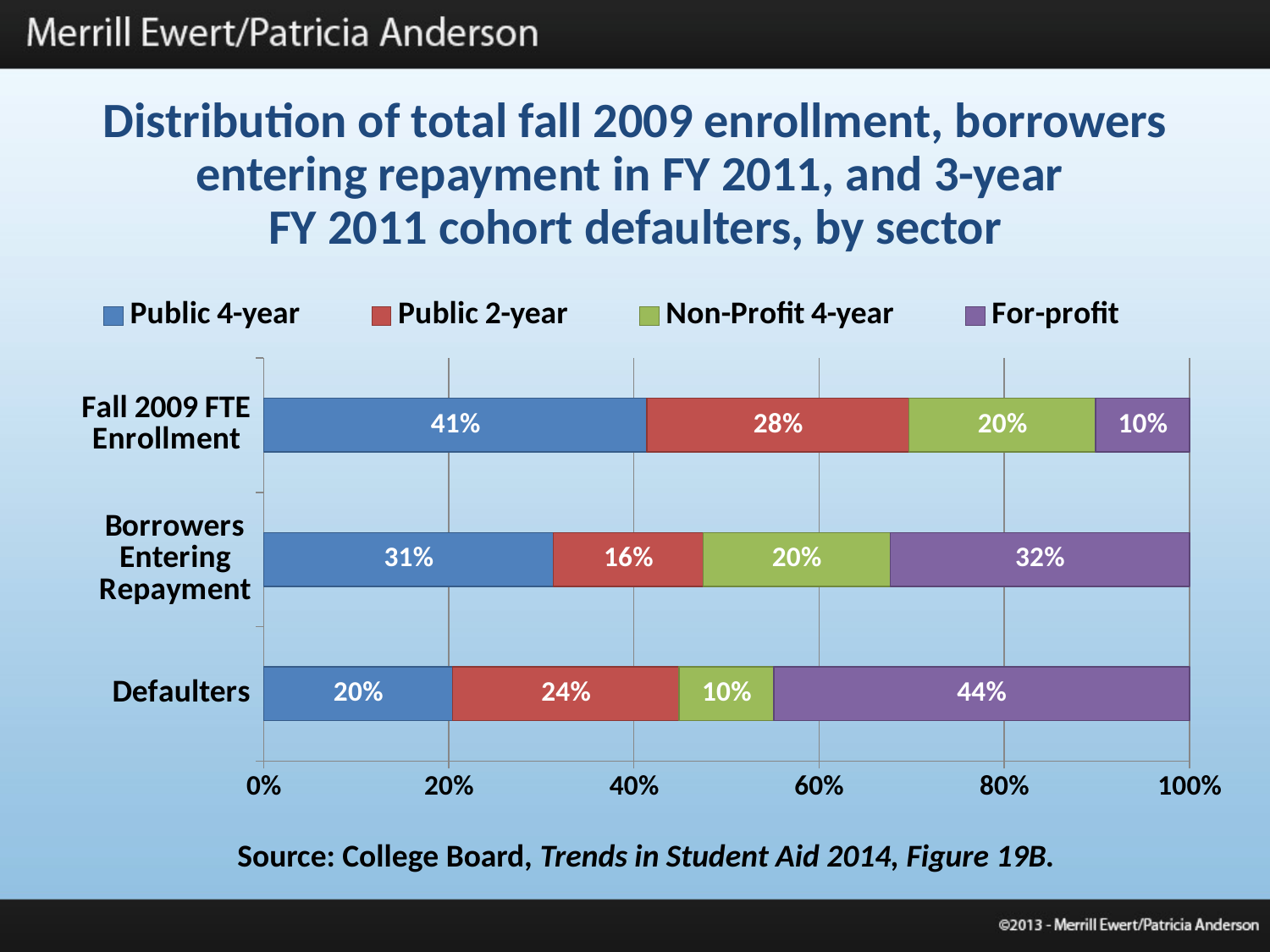
What is the Public 4-year share of Fall 2009 FTE Enrollment? 41% What is the For-profit share of Defaulters? 44% How many categories (bars) are shown on the chart? 3 What is the Non-Profit 4-year share of Defaulters? 10% What is the Public 2-year share of Borrowers Entering Repayment? 16% How many series does the legend list? 4 Which is larger: the Public 2-year share of Defaulters or the Public 2-year share of Borrowers Entering Repayment? Defaulters Which sector has the smallest share of Fall 2009 FTE Enrollment? For-profit What colour represents the For-profit sector in the chart? Purple Which sector has the largest share of Defaulters? For-profit What kind of chart is shown on the slide? Stacked bar chart What is the difference between the For-profit share of Defaulters and the For-profit share of Fall 2009 FTE Enrollment? 34 percentage points